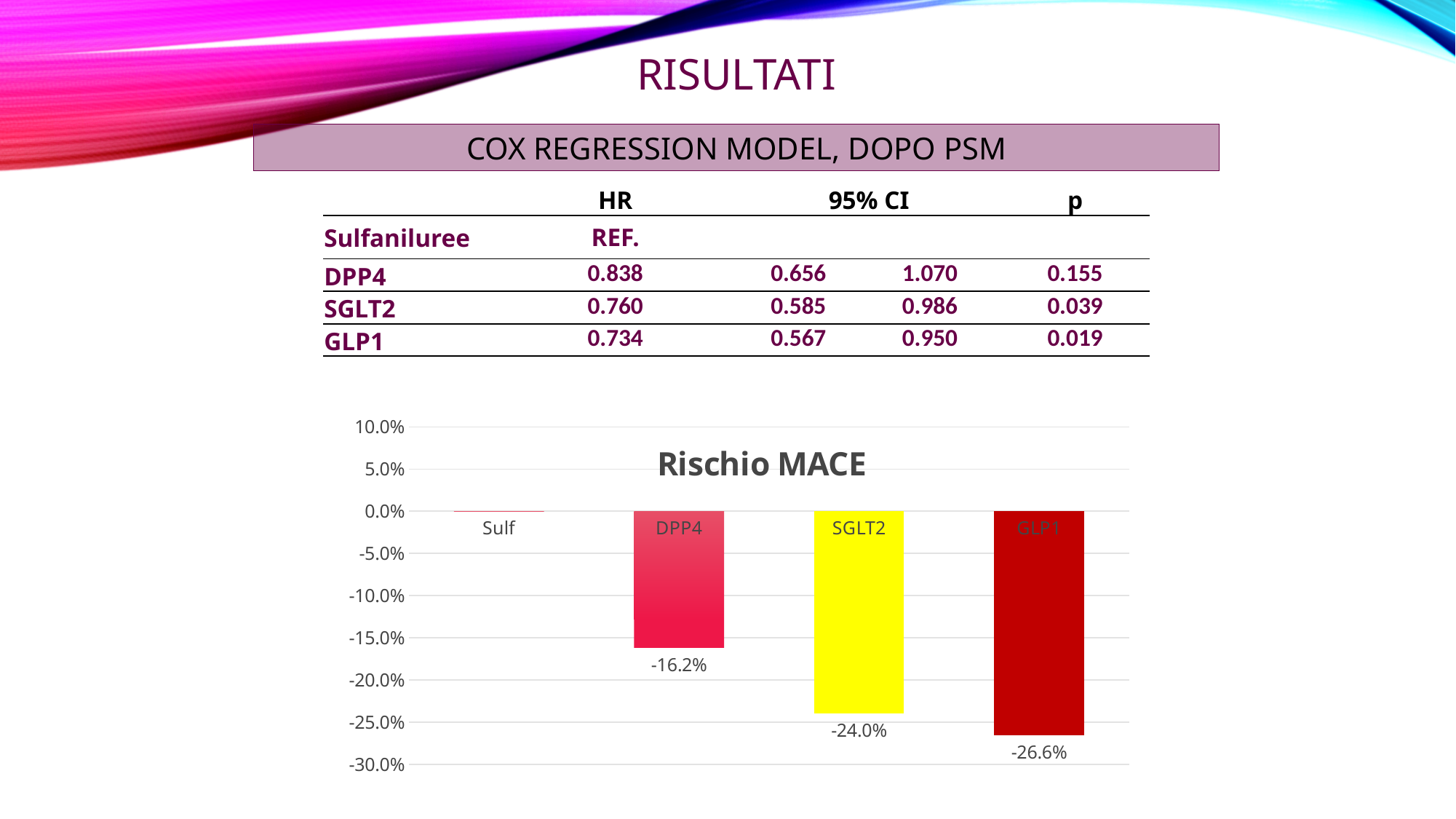
In the Rischio MACE chart, which category has the lowest value? GLP1 In the Rischio MACE chart, what is the difference between the values for SGLT2 and GLP1? 2.6 percentage points In the Rischio MACE chart, which is larger, the value for DPP4 or the value for GLP1? DPP4 In the Rischio MACE chart, which category has the highest value? Sulf How many categories are shown in the Rischio MACE chart? 4 In the Rischio MACE chart, what is the value for SGLT2? -24.0% In the Rischio MACE chart, what is the value for GLP1? -26.6% In the Rischio MACE chart, do the values rise or fall from left to right along the x axis? fall In the Rischio MACE chart, what is the difference between the values for DPP4 and SGLT2? 7.8 percentage points In the Rischio MACE chart, what is the value for DPP4? -16.2% What kind of chart is the Rischio MACE chart? bar chart In the Rischio MACE chart, is the value for SGLT2 greater or less than -20.0%? less